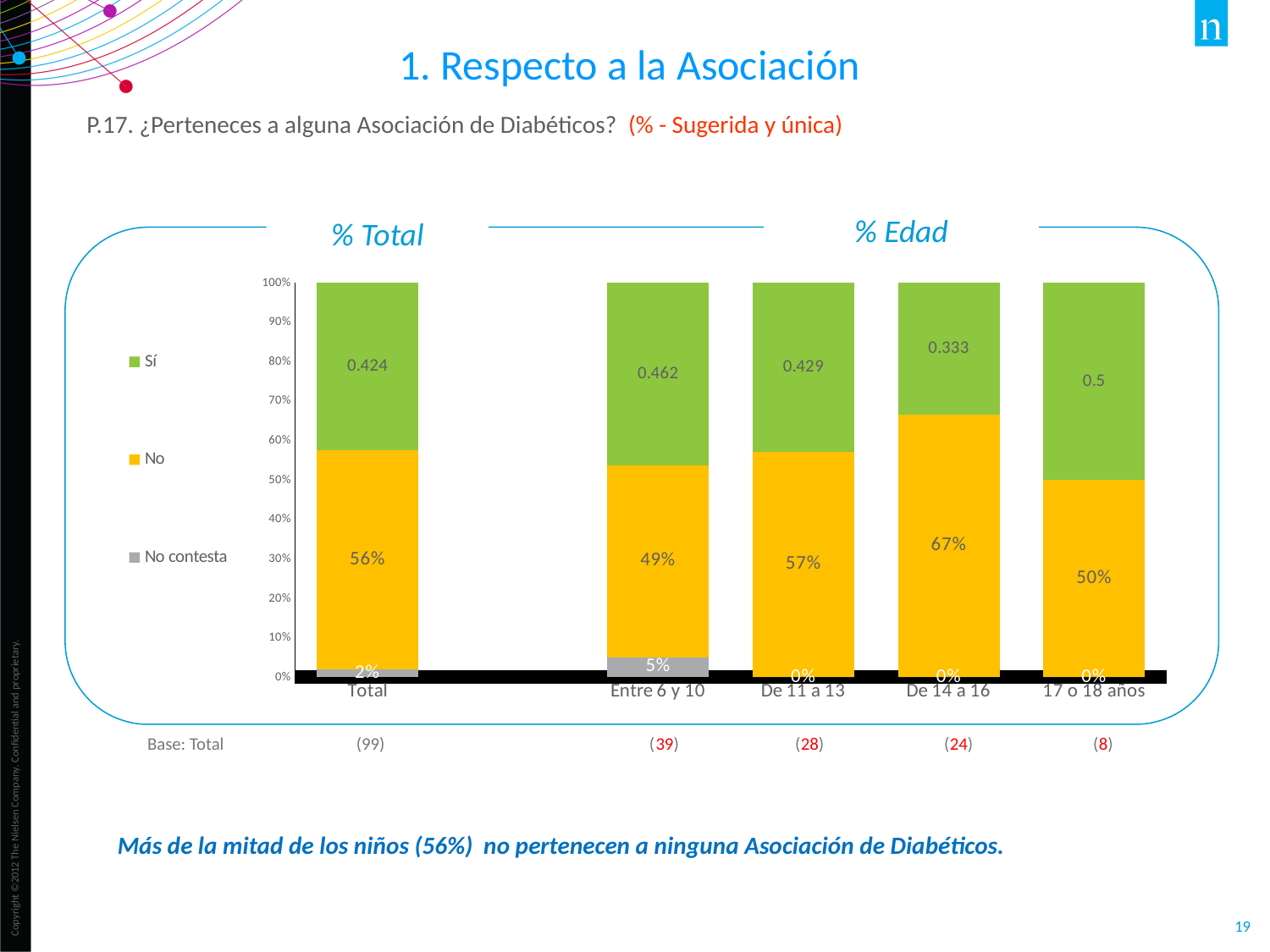
What is the value of the 'Sí' series for the '17 o 18 años' category? 0.5 Which category has the highest value for the 'No' series? De 14 a 16 How many categories are plotted along the x axis? 5 What is the value of the 'No contesta' series for the 'Entre 6 y 10' category? 5% Which legend entry is shown in green? Sí Which category has the lowest value for the 'Sí' series? De 14 a 16 What type of chart is shown on the slide? stacked bar chart Which is larger: the 'No' value for 'De 11 a 13' or for '17 o 18 años'? De 11 a 13 How many series does the legend list? 3 What is the value of the 'No' series for the 'Total' category? 56% What is the value of the 'Sí' series for the 'De 14 a 16' category? 0.333 What is the difference between the 'No' values for 'De 14 a 16' and 'Entre 6 y 10'? 18%